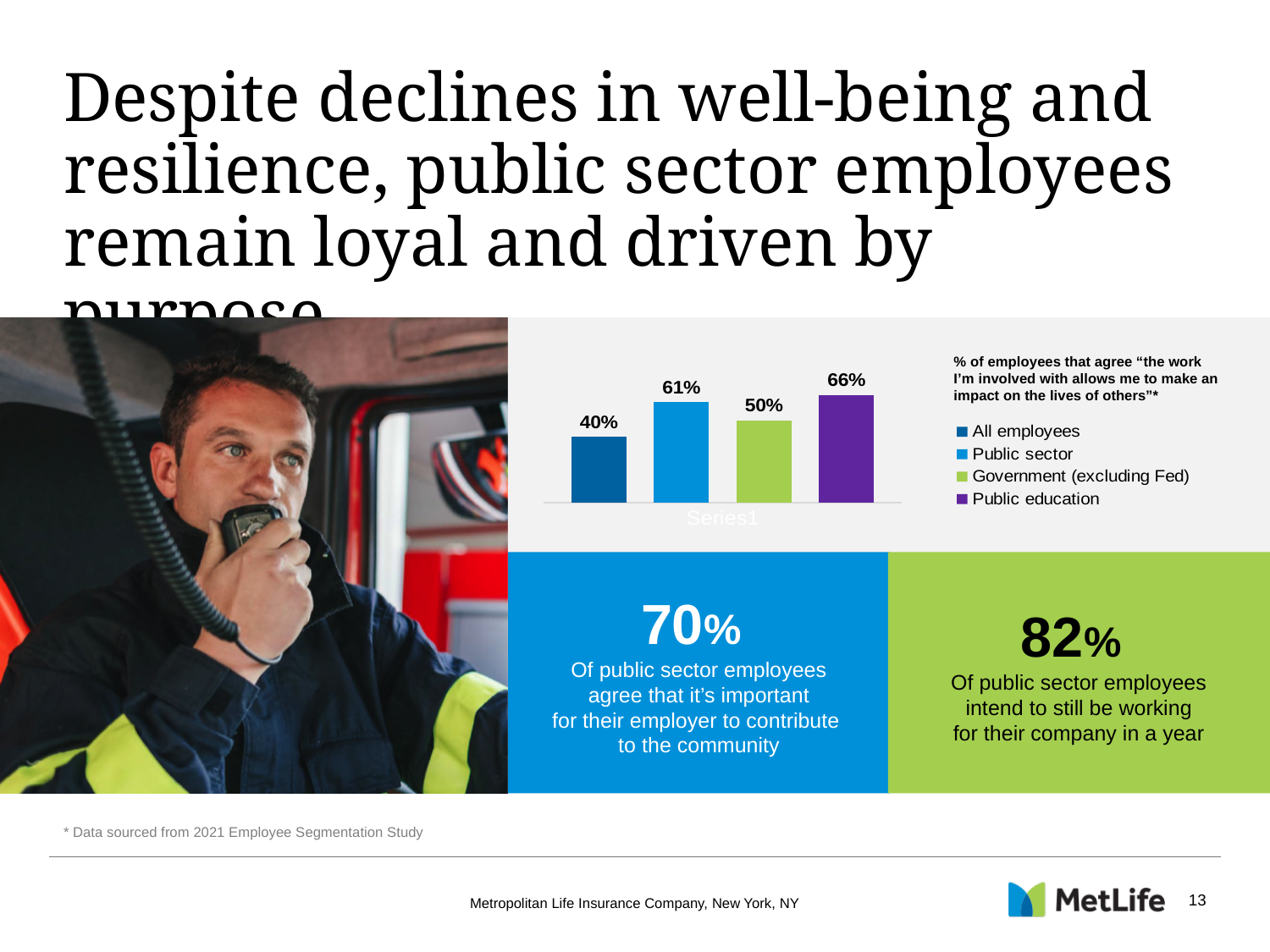
What is the difference between the Public sector and Government (excluding Fed) values in the bar chart? 11% What is the value shown for Public education in the bar chart? 66% What colour is the bar for Government (excluding Fed) in the chart? Green What kind of chart is shown on the slide? Bar chart How many series does the legend of the bar chart list? 4 Which is larger in the bar chart, the value for Public sector or the value for Public education? Public education What is the value shown for Government (excluding Fed) in the bar chart? 50% What is the value shown for Public sector in the bar chart? 61% Which group has the highest value in the bar chart? Public education What is the difference between the Public education and All employees values in the bar chart? 26% What percentage of all employees agree that the work they're involved with allows them to make an impact on the lives of others? 40% Which group has the lowest value in the bar chart? All employees